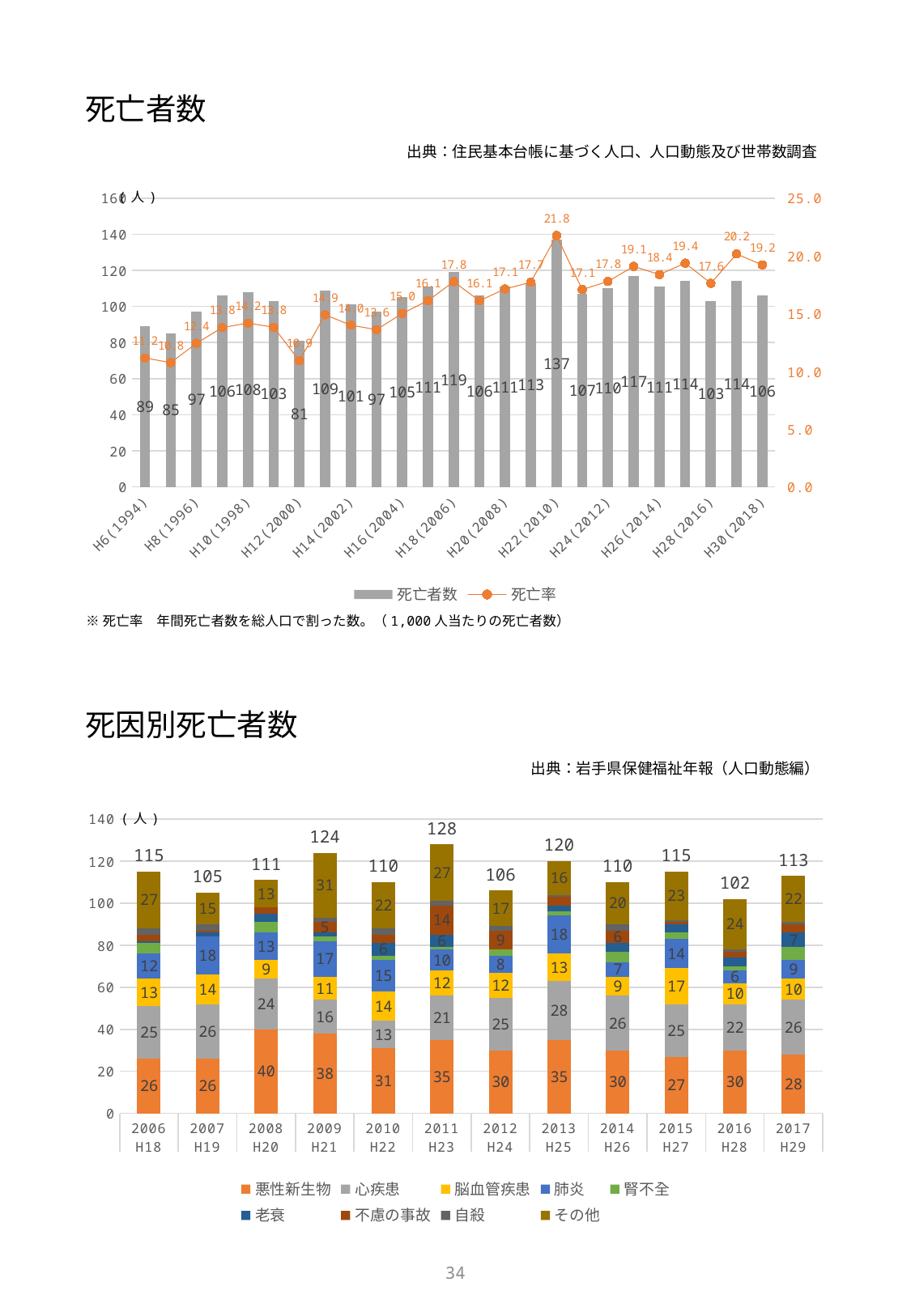
In the top chart titled 死亡者数, how many series does the legend list? 2 In the bottom chart titled 死因別死亡者数, which is larger, the 心疾患 value for 2013 (H25) or for 2010 (H22)? 2013 (H25) In the top chart titled 死亡者数, which year has the highest 死亡率? H22(2010) In the bottom chart titled 死因別死亡者数, what kind of chart is it? stacked bar chart In the bottom chart titled 死因別死亡者数, what is the total of the stacked bar for 2011 (H23)? 128 In the bottom chart titled 死因別死亡者数, how many series does the legend list? 9 In the top chart titled 死亡者数, what is the difference between the 死亡者数 for H22(2010) and H12(2000)? 56 In the bottom chart titled 死因別死亡者数, which year has the lowest total? 2016 (H28) In the top chart titled 死亡者数, which year has the lowest 死亡者数? H12(2000) In the bottom chart titled 死因別死亡者数, what is the 悪性新生物 value for 2008 (H20)? 40 In the top chart titled 死亡者数, what is the 死亡者数 value for H22(2010)? 137 In the top chart titled 死亡者数, what is the 死亡率 value for H30(2018)? 19.2